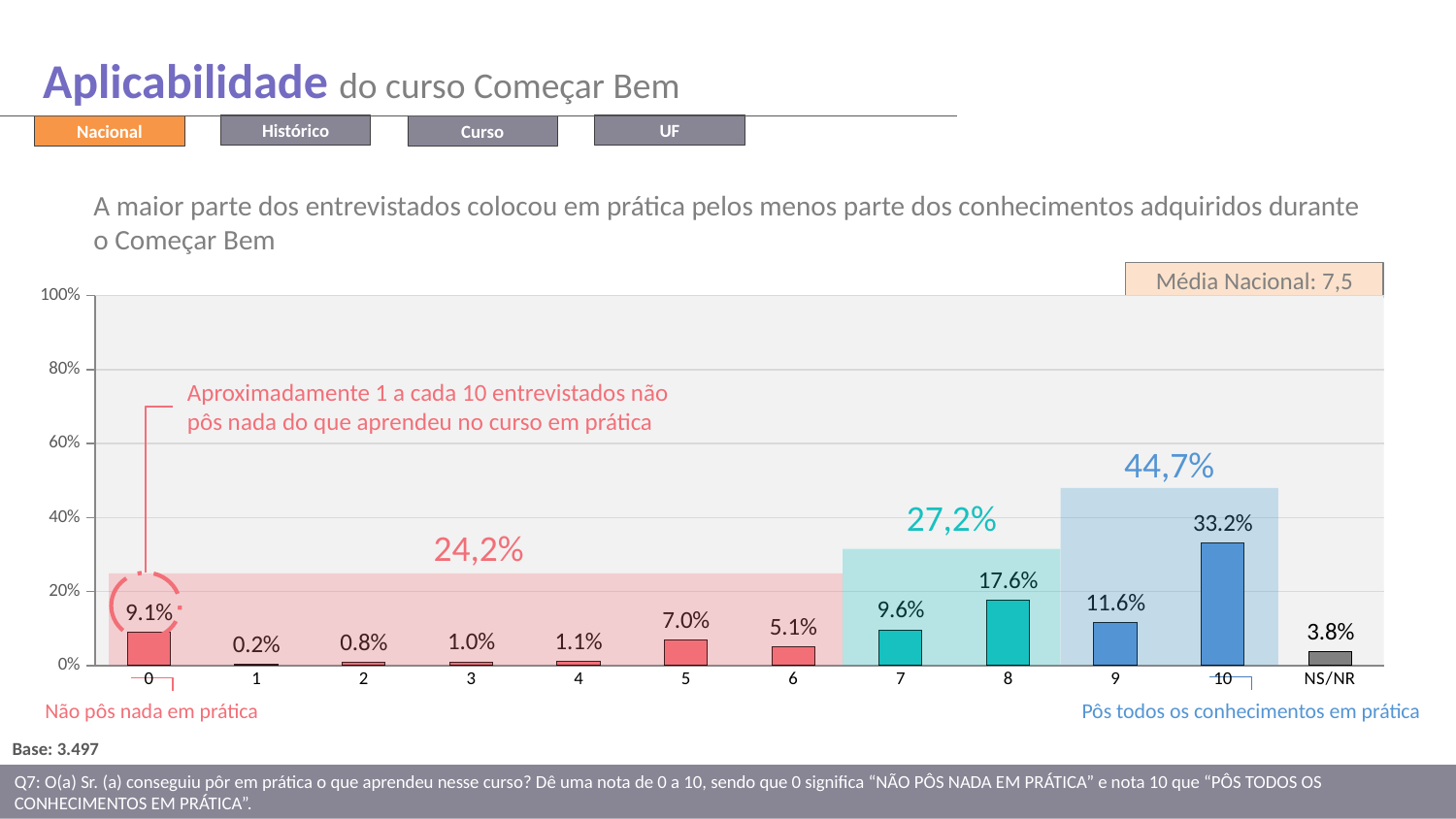
What is the value for category 0? 9.1% Which is larger, the value for category 9 or the value for category 7? 9 What is the Média Nacional shown on the slide? 7,5 What is the value for category 10? 33.2% What is the value for category 8? 17.6% How many categories are shown on the x axis? 12 Which category has the highest value? 10 What is the value for the NS/NR category? 3.8% Is the value for category 10 greater or less than 40%? less What is the difference between the values for category 10 and category 8? 15.6% What kind of chart is shown on the slide? bar chart Which category has the lowest value? 1